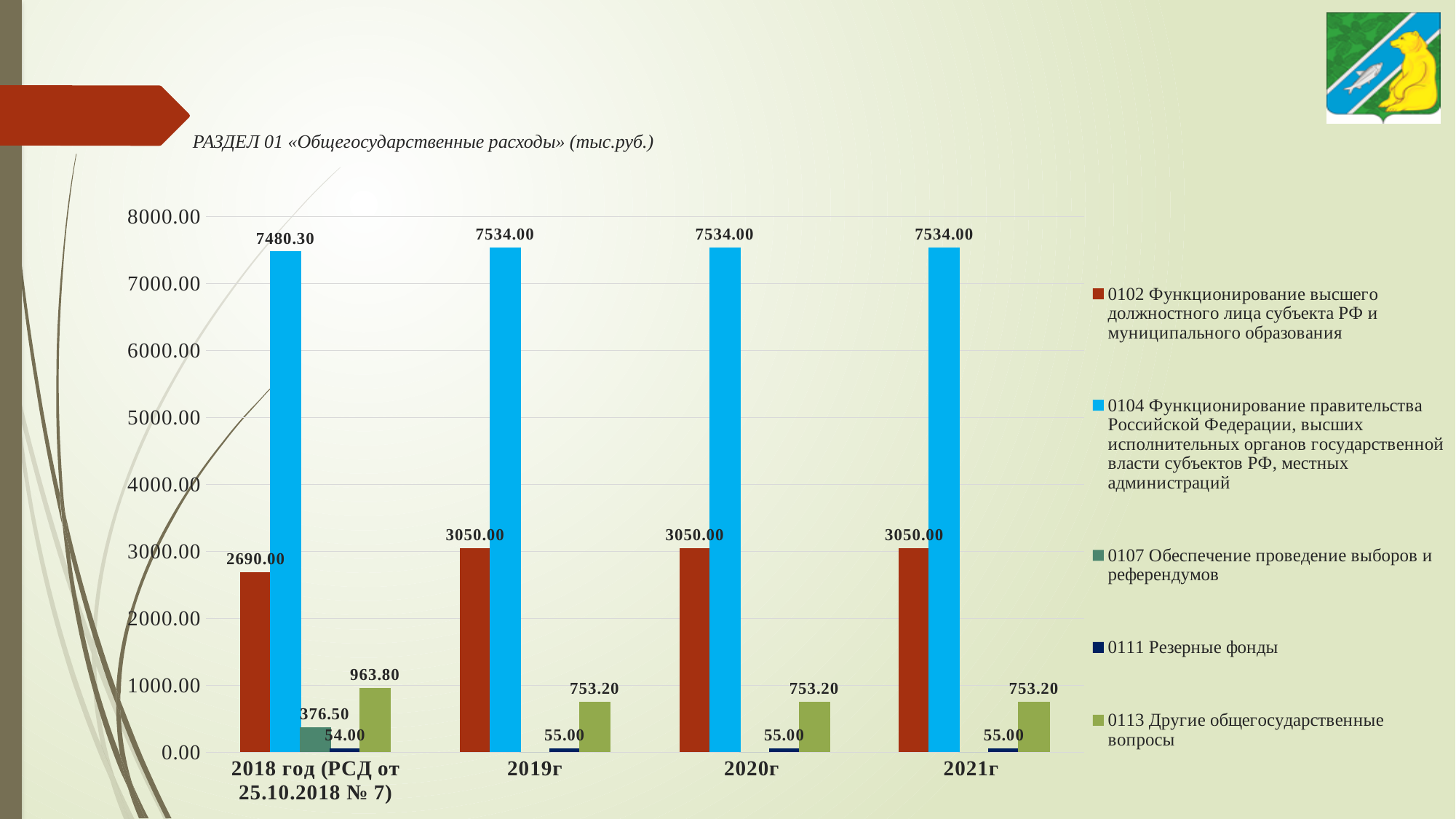
Does the value for series 0102 rise or fall from 2018 год to 2019г? rise Which is larger: the 0113 value in 2018 год or the 0113 value in 2019г? 2018 год How many year categories are shown on the x axis? 4 What is the value for series 0104 in 2019г? 7534.00 What kind of chart is shown on the slide? bar chart What is the value for series 0113 Другие общегосударственные вопросы in 2020г? 753.20 Which series has the lowest value in the 2018 год category? 0111 Резерные фонды Which series has the highest value in 2021г? 0104 Функционирование правительства Российской Федерации, высших исполнительных органов государственной власти субъектов РФ, местных администраций What is the difference between the 0104 value in 2019г and the 0104 value in 2018 год? 53.70 How many series does the legend list? 5 What is the value for series 0102 in the 2018 год category? 2690.00 What is the value for series 0107 Обеспечение проведение выборов и референдумов in the 2018 год category? 376.50